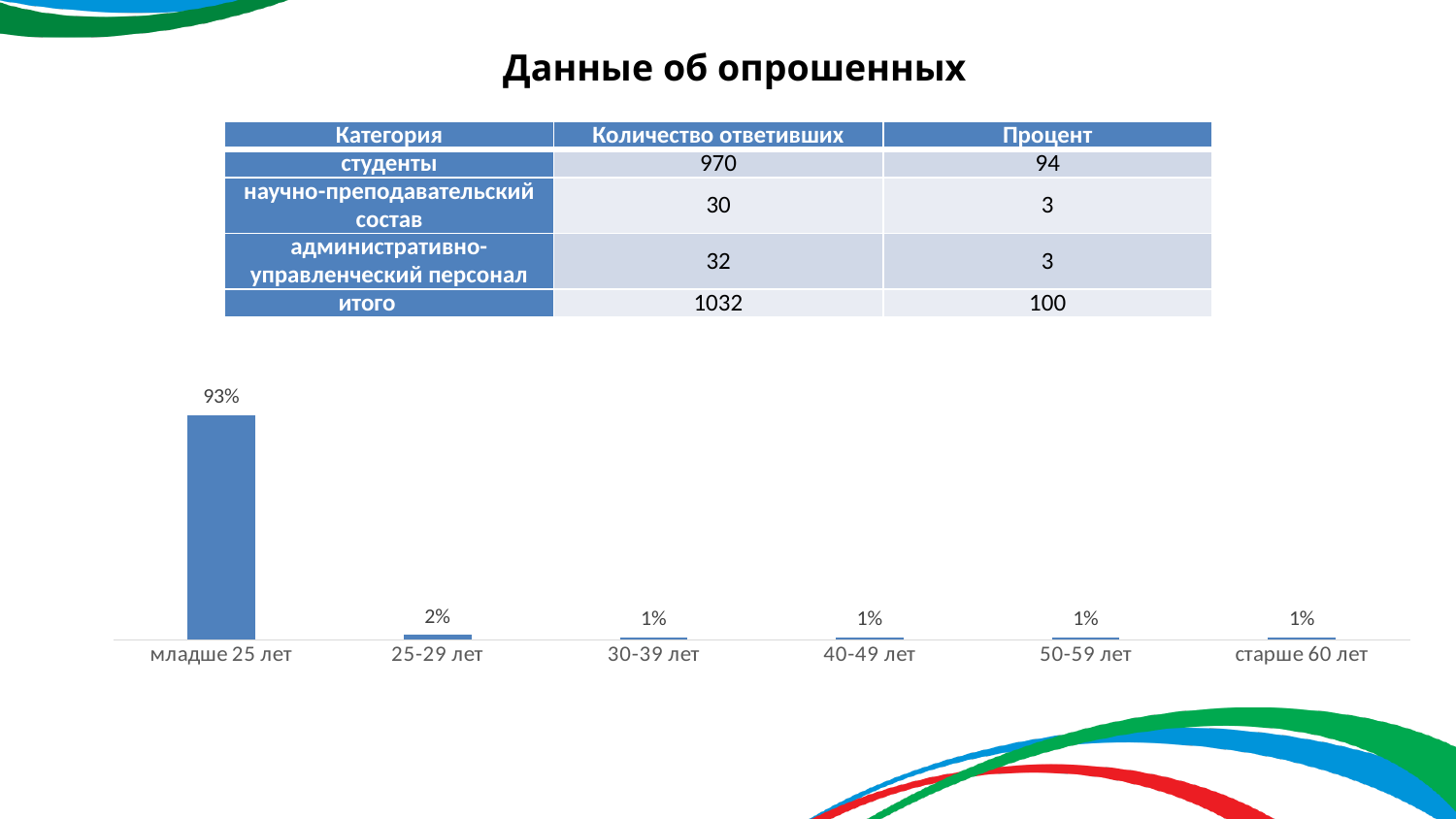
What type of chart is shown on the slide? bar chart Which age category has the highest value in the bar chart? младше 25 лет Do the values in the bar chart rise or fall from 'младше 25 лет' to '25-29 лет'? fall Which is larger in the bar chart: the value for '25-29 лет' or the value for '50-59 лет'? 25-29 лет What is the label of the first category on the x axis of the bar chart? младше 25 лет What is the value for the category 'младше 25 лет' in the bar chart? 93% What is the value for the category '25-29 лет' in the bar chart? 2% What is the value for the category 'старше 60 лет' in the bar chart? 1% What is the difference between the values for 'младше 25 лет' and '25-29 лет' in the bar chart? 91% How many age categories are shown in the bar chart? 6 What is the value for the category '30-39 лет' in the bar chart? 1% What is the difference between the values for '25-29 лет' and '40-49 лет' in the bar chart? 1%